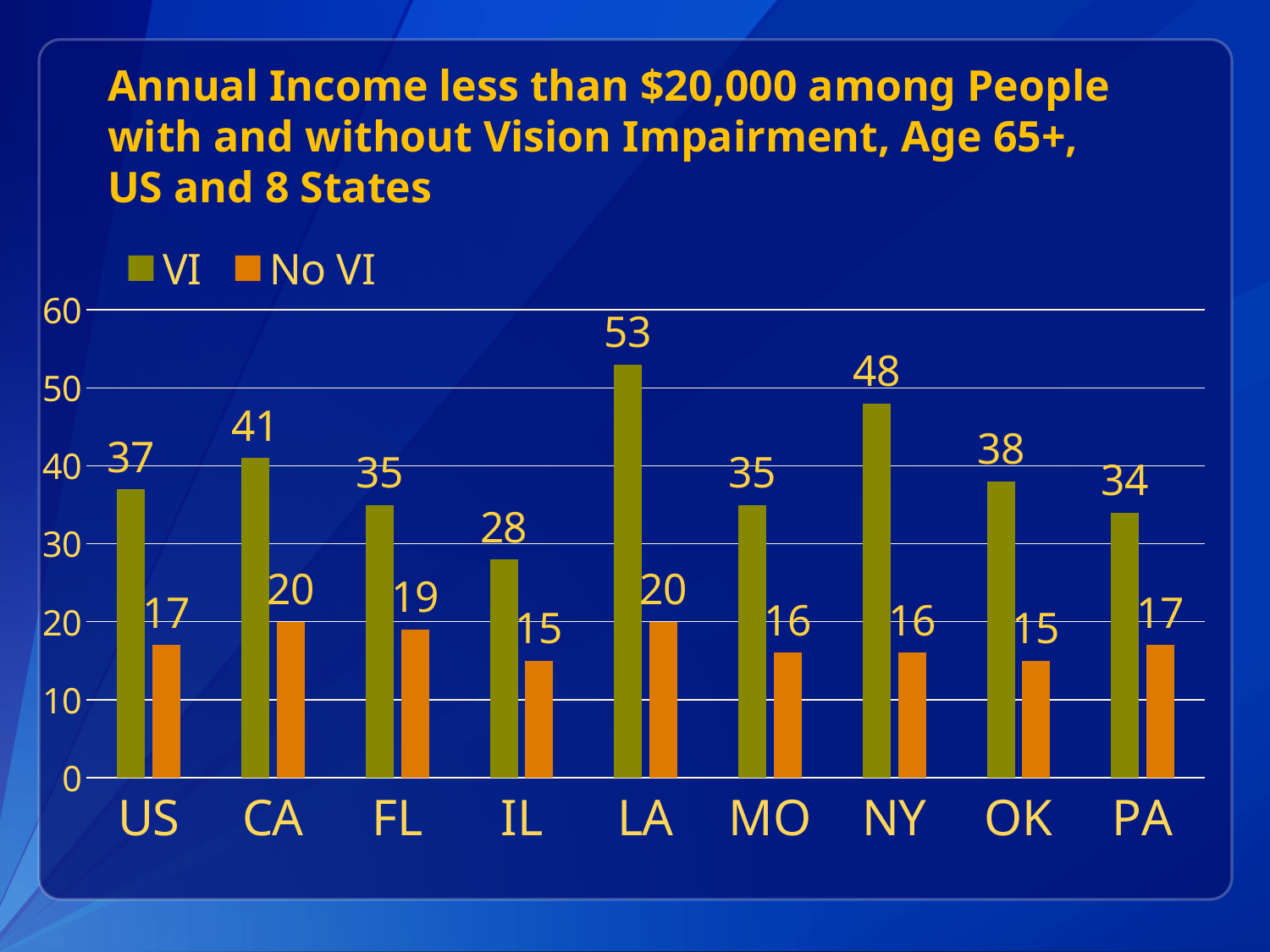
Which category has the lowest VI value? IL What is the VI value for IL? 28 What is the VI value for LA? 53 How many categories are shown on the x axis? 9 How many series does the legend list? 2 What kind of chart is shown on the slide? bar chart Is the VI value for PA greater or less than 30? greater What is the No VI value for FL? 19 Which category has the highest VI value? LA What is the difference between the VI and No VI values for NY? 32 Which series is shown in orange? No VI Which is larger, the VI value for CA or the VI value for OK? CA